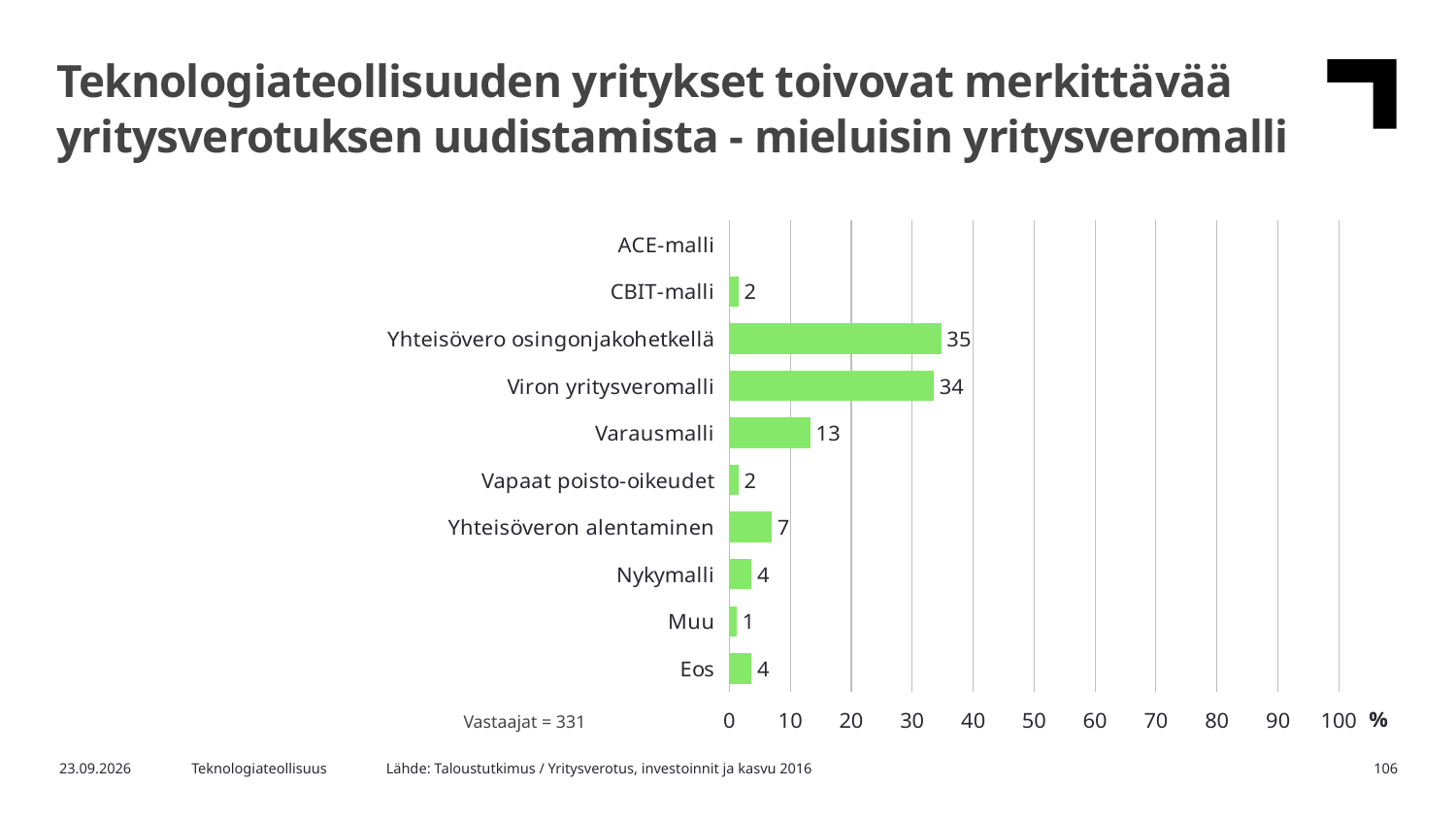
What is the difference between the values for Varausmalli and Yhteisöveron alentaminen? 6 What value is shown for Yhteisöveron alentaminen? 7 What value is shown for Varausmalli? 13 What kind of chart is shown on the slide? Bar chart What value is shown for Muu? 1 What is the difference between the values for Yhteisövero osingonjakohetkellä and Viron yritysveromalli? 1 Which category has the highest value? Yhteisövero osingonjakohetkellä What is the number of respondents (Vastaajat) stated below the chart? 331 Which is larger, the value for Nykymalli or the value for Yhteisöveron alentaminen? Yhteisöveron alentaminen What value is shown for Viron yritysveromalli? 34 Is the value for Viron yritysveromalli greater or less than 30? greater How many categories are listed on the vertical axis? 10